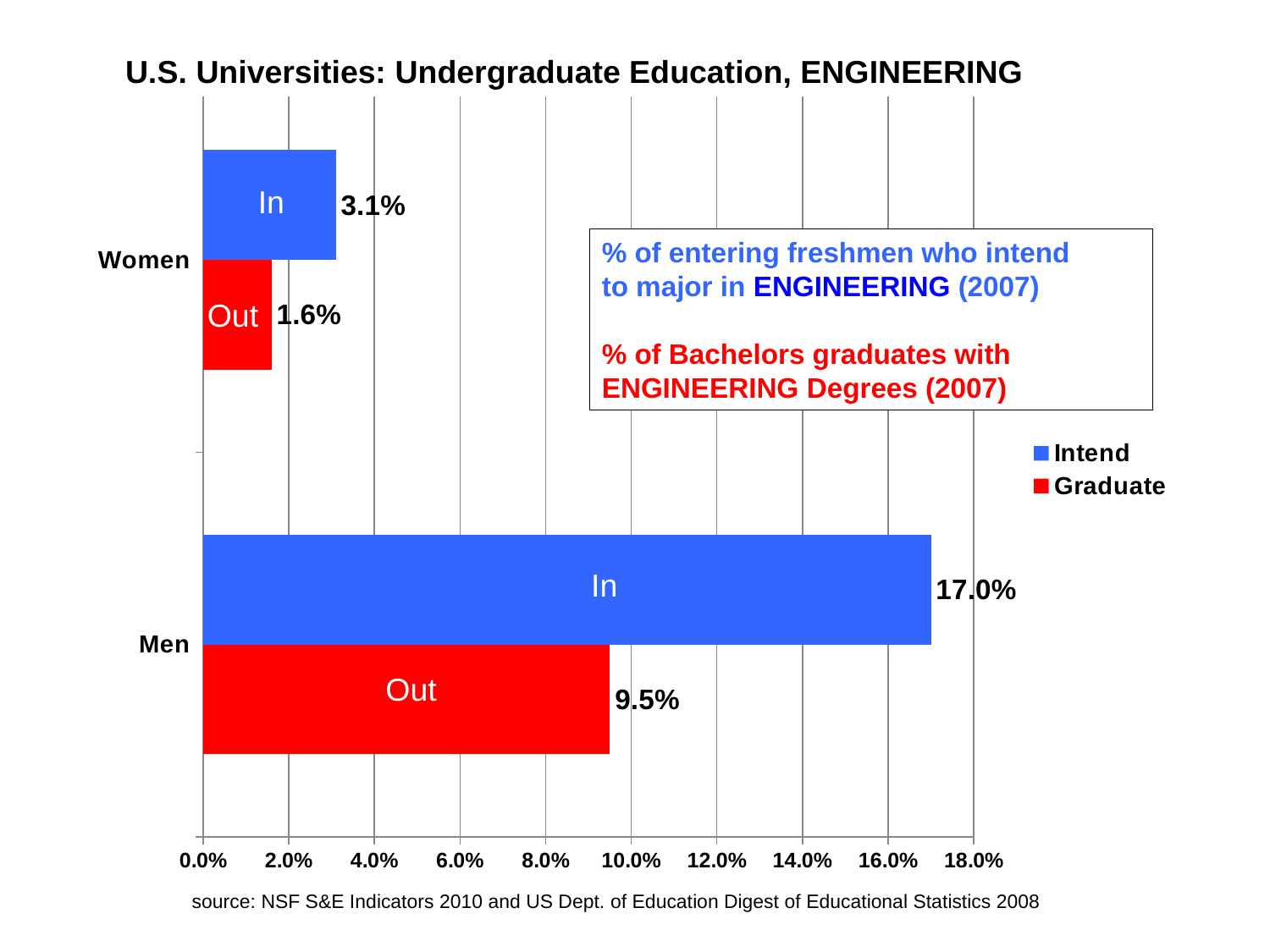
What is the Graduate value for Men? 9.5% What is the difference between the Intend and Graduate values for Men? 7.5% What is the Graduate value for Women? 1.6% What is the Intend value for Women? 3.1% What is the difference between the Intend values for Men and Women? 13.9% Which is larger, the Graduate value for Men or the Intend value for Women? Graduate value for Men What colour are the Graduate bars? Red What is the Intend value for Men? 17.0% Which bar has the lowest value on the chart? Women, Graduate Which bar has the highest value on the chart? Men, Intend What kind of chart is shown on the slide? Bar chart How many series does the legend list? 2